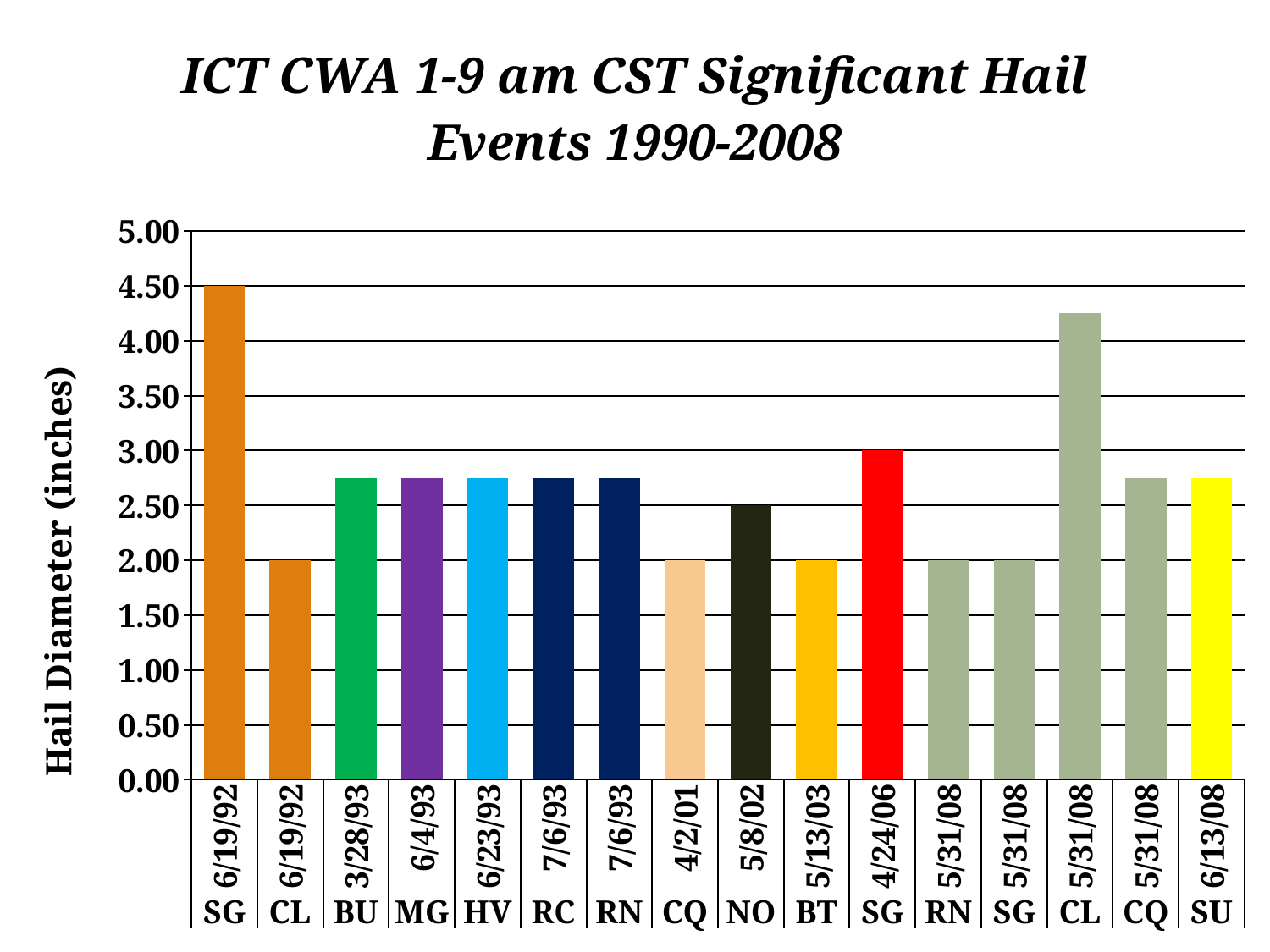
What is the label of the vertical axis? Hail Diameter (inches) What is the hail diameter for the 4/24/06 SG event? 3.00 Is the hail diameter for the 5/31/08 CL event greater or less than 4.00? greater Is the hail diameter for the 3/28/93 BU event greater or less than 2.50? greater What is the hail diameter for the 5/8/02 NO event? 2.50 Which event has the largest hail diameter? 6/19/92 SG What type of chart is shown on the slide? bar chart How many events (bars) are plotted on the chart? 16 What is the hail diameter for the 6/19/92 CL event? 2.00 Which has the larger hail diameter, the 5/8/02 NO event or the 5/13/03 BT event? 5/8/02 NO What is the difference in hail diameter between the 6/19/92 SG event and the 4/24/06 SG event? 1.50 What is the hail diameter for the 6/19/92 SG event? 4.50